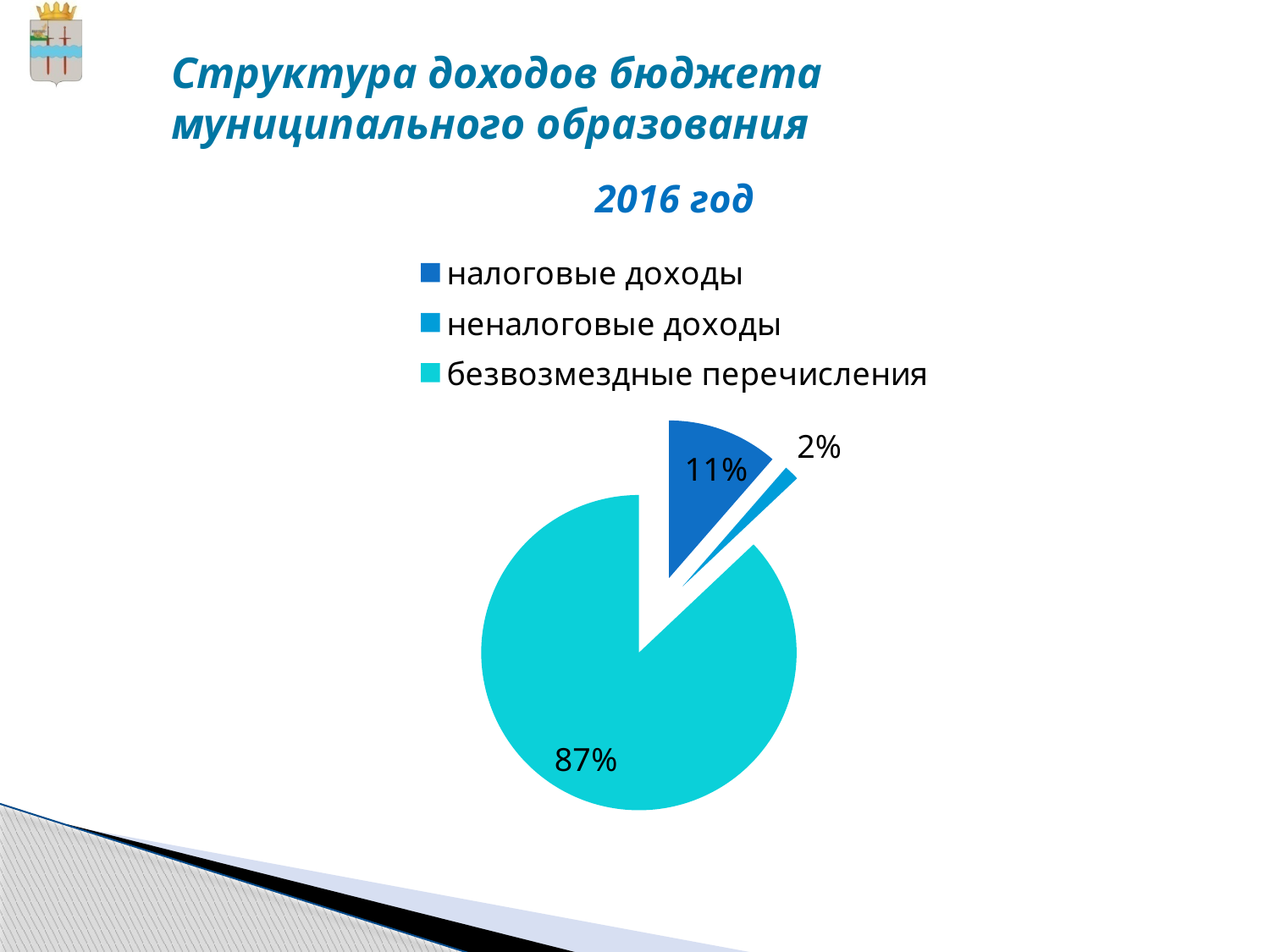
What year does the chart title refer to? 2016 год What is the difference in percentage points between безвозмездные перечисления and налоговые доходы? 76 How many categories does the pie chart show? 3 Which legend entry is shown in dark blue? налоговые доходы What is the difference in percentage points between налоговые доходы and неналоговые доходы? 9 What kind of chart is shown on the slide? pie chart What share of the pie does налоговые доходы take? 11% What share of the pie does безвозмездные перечисления take? 87% Which is larger, налоговые доходы or неналоговые доходы? налоговые доходы Which category has the largest slice of the pie? безвозмездные перечисления What share of the pie does неналоговые доходы take? 2% Which category has the smallest slice of the pie? неналоговые доходы